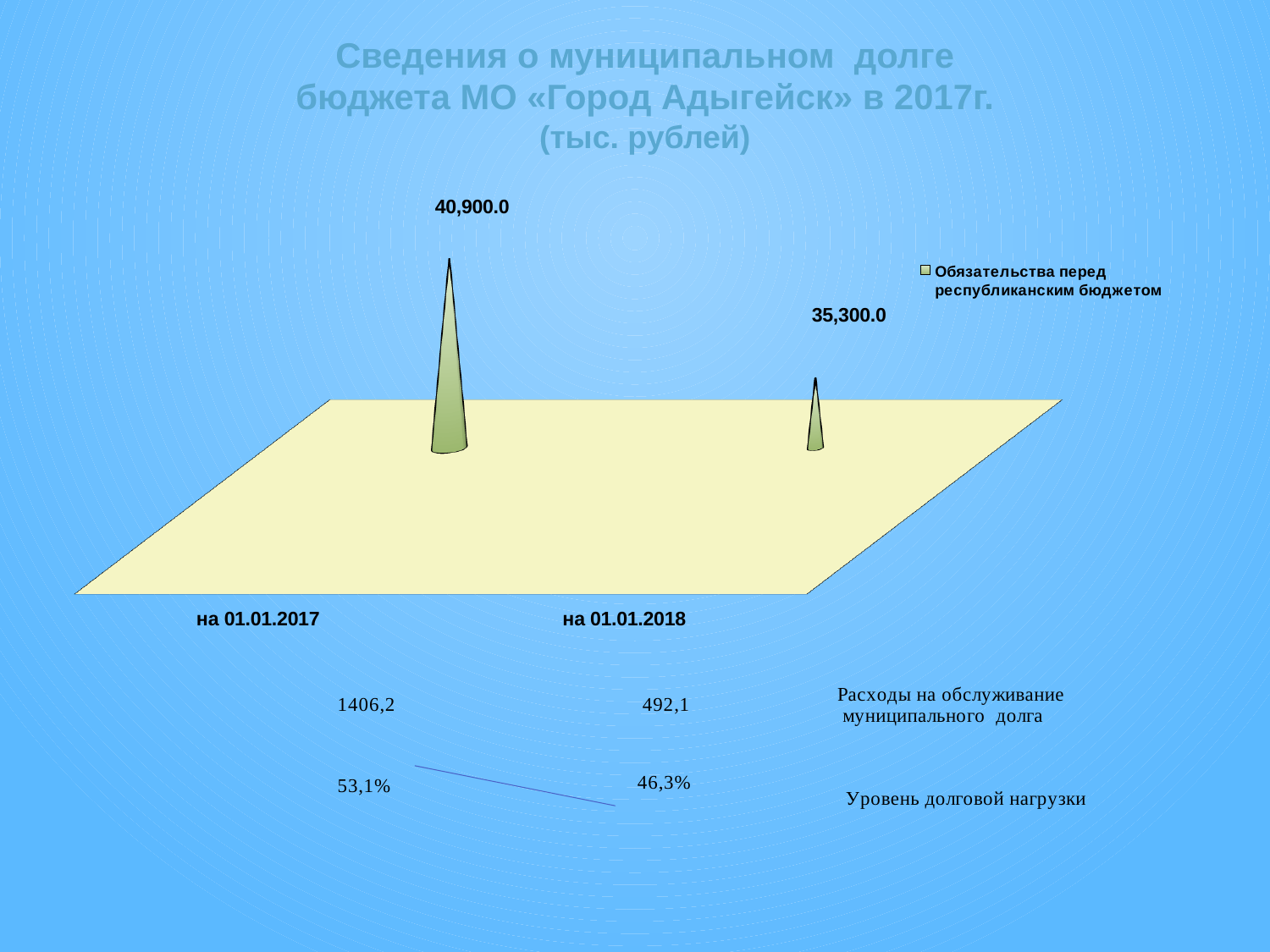
What is the value for "на 01.01.2017" in the chart? 40,900.0 What unit is stated in the chart title? тыс. рублей Which category has the lowest value in the chart? на 01.01.2018 What is the difference between the values for "на 01.01.2017" and "на 01.01.2018"? 5,600.0 What kind of chart is shown on the slide? bar chart How many series does the chart legend list? 1 What series name is shown in the chart legend? Обязательства перед республиканским бюджетом Do the values rise or fall from "на 01.01.2017" to "на 01.01.2018"? fall Which category has the highest value in the chart? на 01.01.2017 What is the value for "на 01.01.2018" in the chart? 35,300.0 Which is larger: the value for "на 01.01.2017" or the value for "на 01.01.2018"? на 01.01.2017 How many categories are plotted in the chart? 2